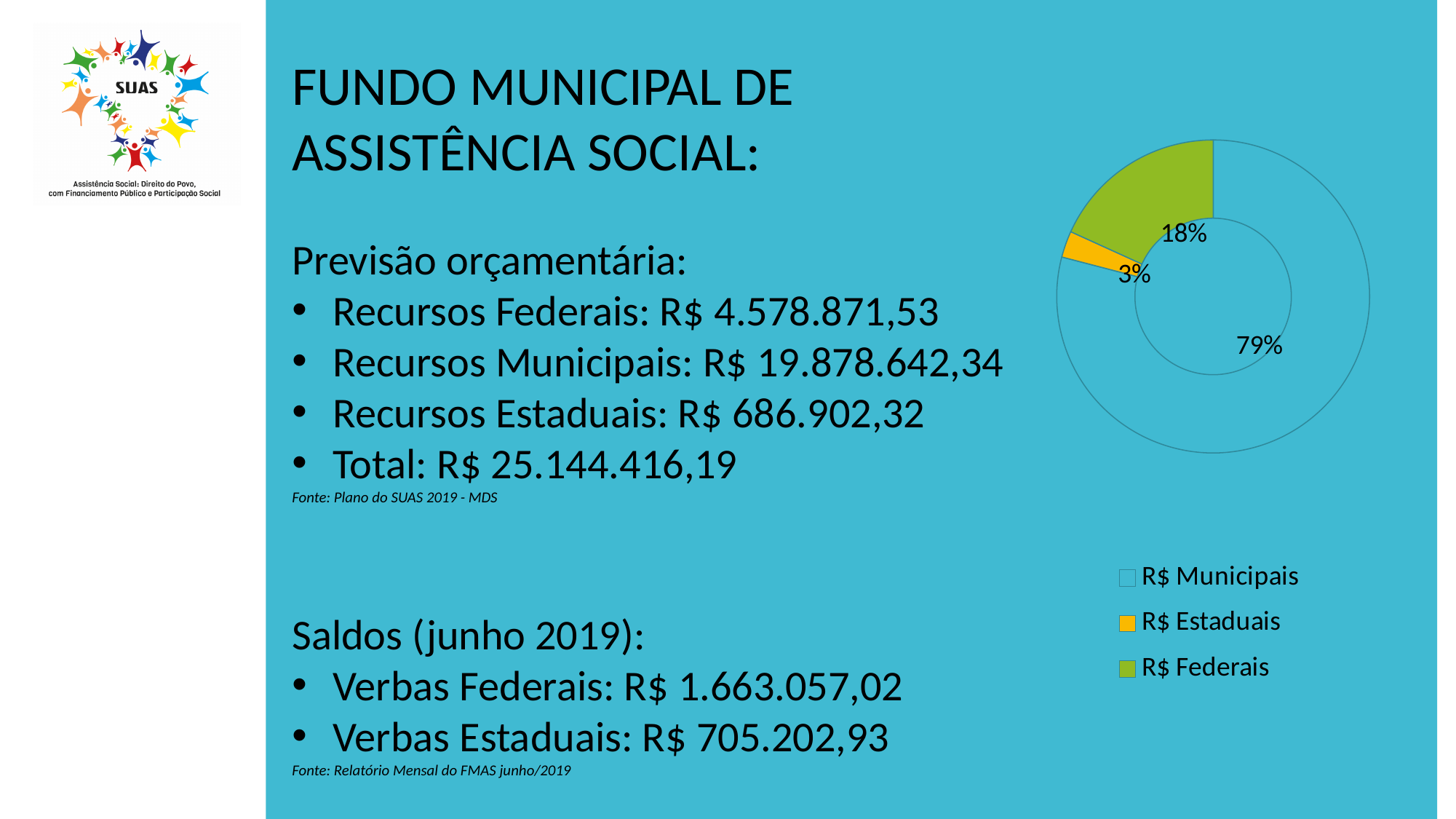
What share of the chart does R$ Federais represent? 18% Which is larger, the share for R$ Federais or the share for R$ Estaduais? R$ Federais Which category has the smallest share in the chart? R$ Estaduais What is the difference in percentage points between the R$ Federais and R$ Estaduais shares? 15 How many categories does the chart's legend list? 3 What kind of chart is shown on the slide? doughnut chart What colour is the R$ Estaduais slice in the chart? orange What share of the chart does R$ Municipais represent? 79% What is the difference in percentage points between the R$ Municipais and R$ Federais shares? 61 What colour is the R$ Federais slice in the chart? green Which category has the largest share in the chart? R$ Municipais What share of the chart does R$ Estaduais represent? 3%